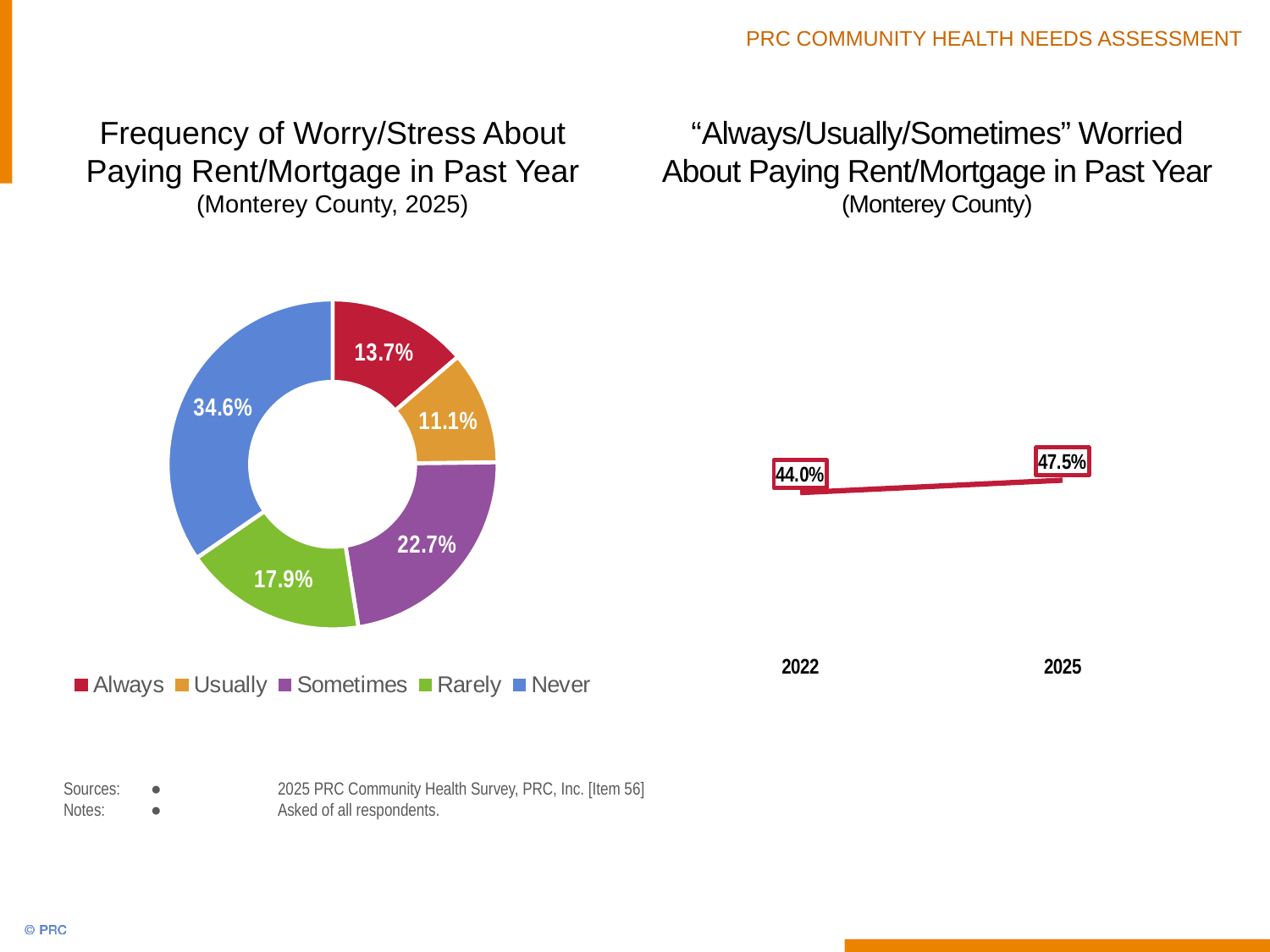
In the left chart (Frequency of Worry/Stress About Paying Rent/Mortgage in Past Year), how many categories does the legend list? 5 In the left chart (Frequency of Worry/Stress About Paying Rent/Mortgage in Past Year), what percentage of respondents answered "Never"? 34.6% In the right chart ("Always/Usually/Sometimes" Worried About Paying Rent/Mortgage in Past Year), does the value rise or fall from 2022 to 2025? Rise In the left chart (Frequency of Worry/Stress About Paying Rent/Mortgage in Past Year), which category has the largest share? Never In the right chart ("Always/Usually/Sometimes" Worried About Paying Rent/Mortgage in Past Year), what is the value for 2025? 47.5% In the left chart (Frequency of Worry/Stress About Paying Rent/Mortgage in Past Year), which category has the smallest share? Usually In the left chart (Frequency of Worry/Stress About Paying Rent/Mortgage in Past Year), what percentage of respondents answered "Sometimes"? 22.7% In the left chart (Frequency of Worry/Stress About Paying Rent/Mortgage in Past Year), what is the difference in percentage points between "Always" and "Rarely"? 4.2 In the left chart (Frequency of Worry/Stress About Paying Rent/Mortgage in Past Year), which is larger, "Sometimes" or "Rarely"? Sometimes What kind of chart is the left chart (Frequency of Worry/Stress About Paying Rent/Mortgage in Past Year)? Doughnut (pie) chart In the right chart ("Always/Usually/Sometimes" Worried About Paying Rent/Mortgage in Past Year), what is the value for 2022? 44.0% In the left chart (Frequency of Worry/Stress About Paying Rent/Mortgage in Past Year), what percentage of respondents answered "Usually"? 11.1%